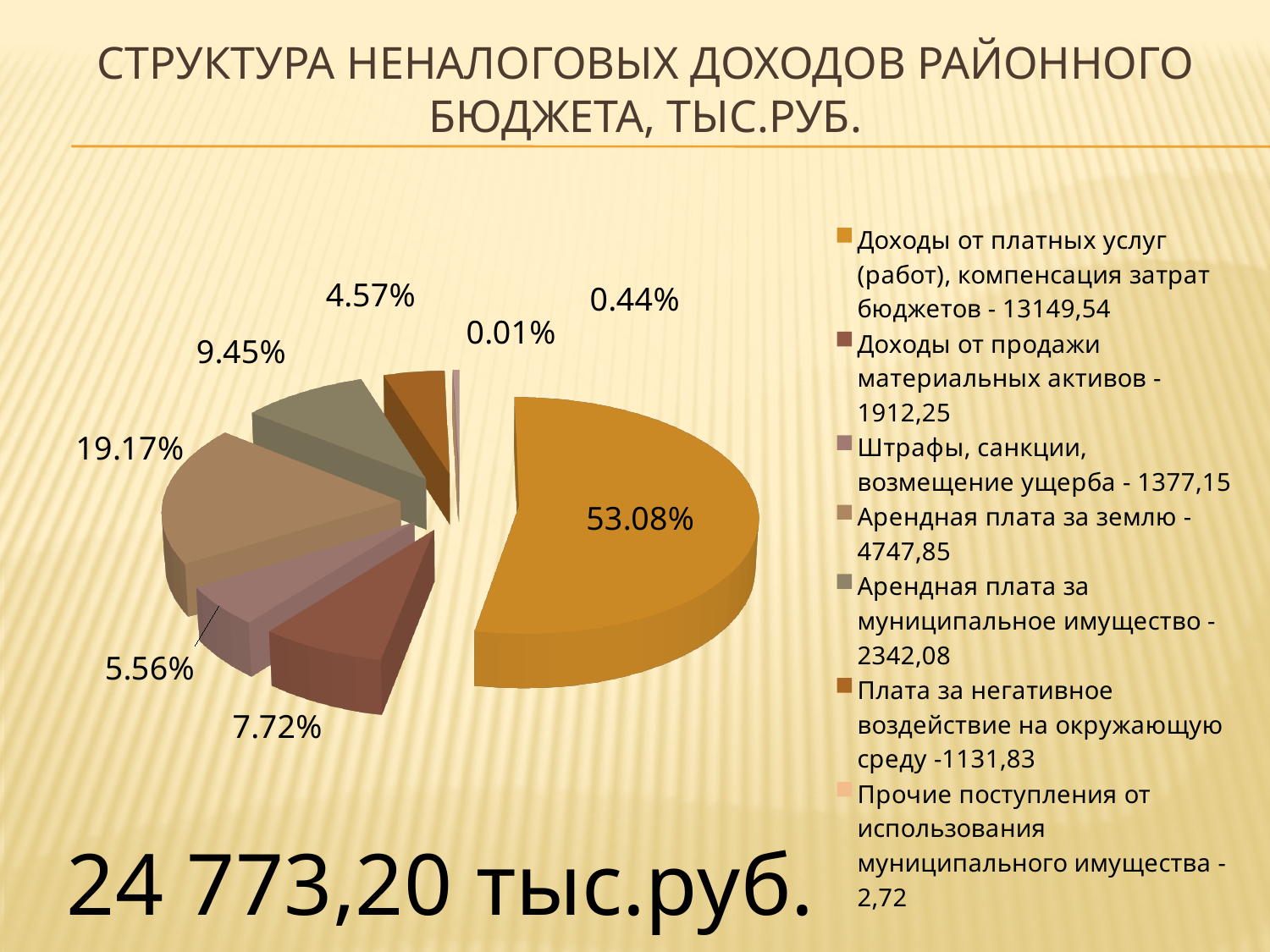
What kind of chart is shown on the slide? Pie chart What total amount of non-tax revenues is printed at the bottom of the slide? 24 773,20 тыс.руб. What is the difference in percentage points between the 53.08% slice and the 19.17% slice? 33.91 How many entries does the legend list? 7 What value in тыс.руб. does the legend give for Доходы от продажи материальных активов? 1912,25 Which category has the largest share of non-tax revenues? Доходы от платных услуг (работ), компенсация затрат бюджетов Which is larger: the share of Доходы от продажи материальных активов or the share of Штрафы, санкции, возмещение ущерба? Доходы от продажи материальных активов What percentage share does the largest slice of the pie have? 53.08% What is the percentage share of Штрафы, санкции, возмещение ущерба? 5.56% What value in тыс.руб. does the legend give for Плата за негативное воздействие на окружающую среду? 1131,83 What is the percentage share of Арендная плата за землю? 19.17% What is the percentage share of Арендная плата за муниципальное имущество? 9.45%